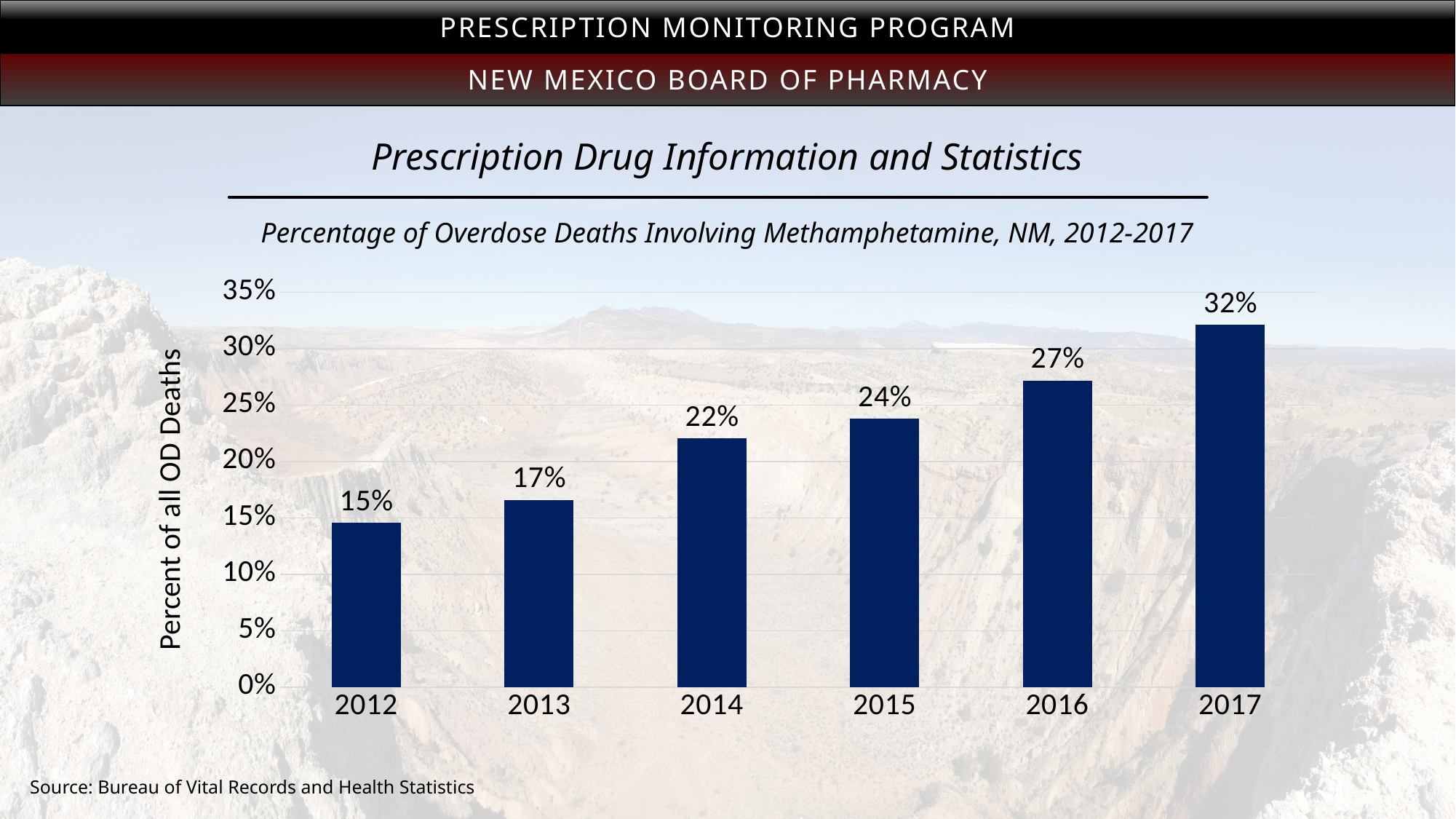
How many years are shown on the x axis? 6 Do the values rise or fall from 2012 to 2017? Rise Which year has a larger value, 2013 or 2015? 2015 What is the value shown for 2017? 32% What is the difference in percentage points between 2017 and 2012? 17 Which year has the highest percentage of overdose deaths involving methamphetamine? 2017 What is the value shown for 2012? 15% What kind of chart is shown on the slide? Bar chart Which year has the lowest percentage of overdose deaths involving methamphetamine? 2012 What percentage of overdose deaths involved methamphetamine in 2014? 22% What is the difference in percentage points between 2016 and 2015? 3 Is the value for 2016 greater or less than 25%? greater